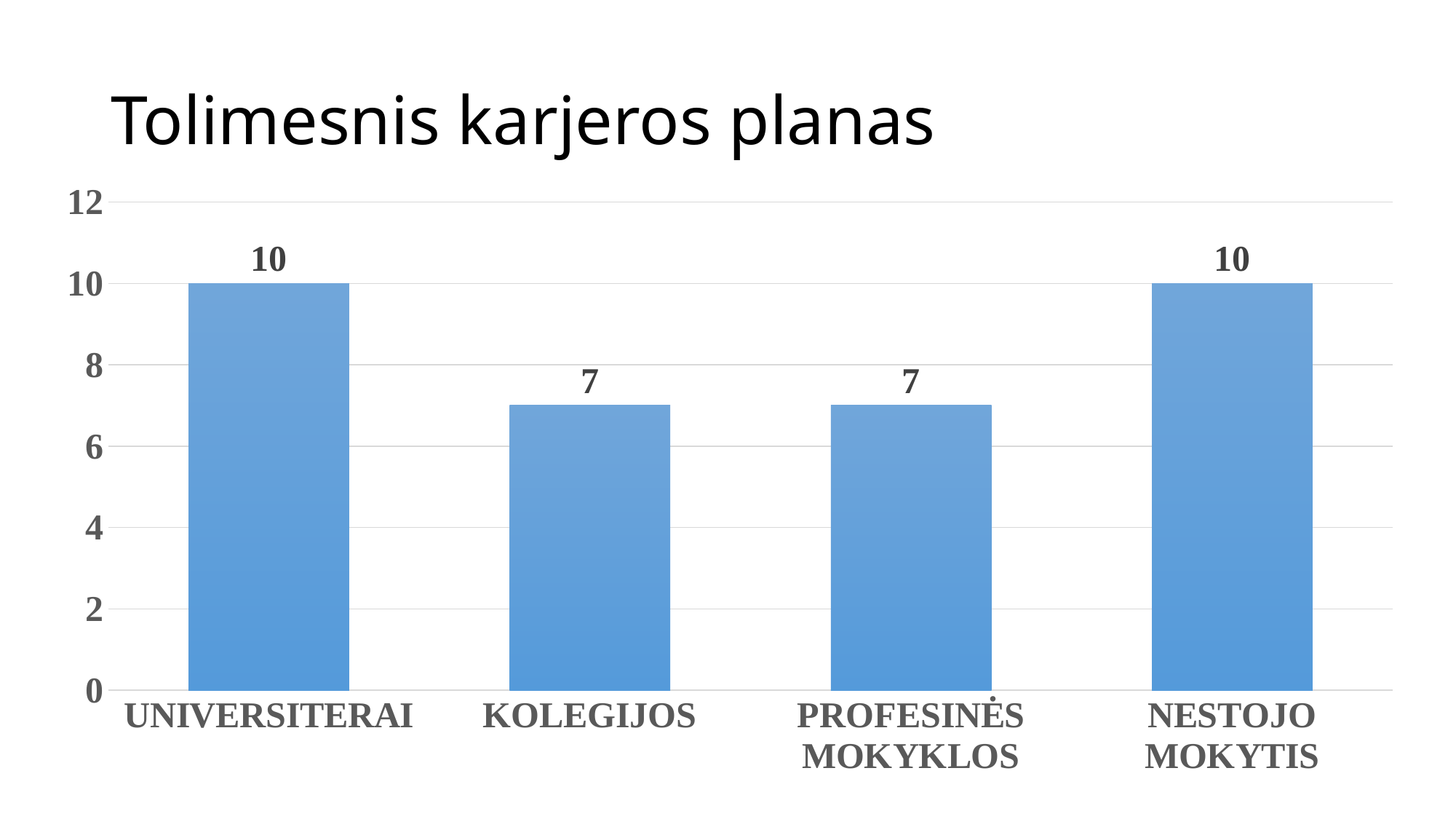
What is the value for NESTOJO MOKYTIS? 10 What is the highest value shown on the vertical axis? 12 What is the value for UNIVERSITERAI? 10 What is the difference between the values for UNIVERSITERAI and KOLEGIJOS? 3 Which is larger, the value for NESTOJO MOKYTIS or the value for PROFESINĖS MOKYKLOS? NESTOJO MOKYTIS Is the value for UNIVERSITERAI greater or less than 8? greater How many categories are shown on the chart? 4 Is the value for KOLEGIJOS greater or less than 8? less What is the value for KOLEGIJOS? 7 What kind of chart is shown on the slide? bar chart What is the value for PROFESINĖS MOKYKLOS? 7 What is the title of the slide? Tolimesnis karjeros planas